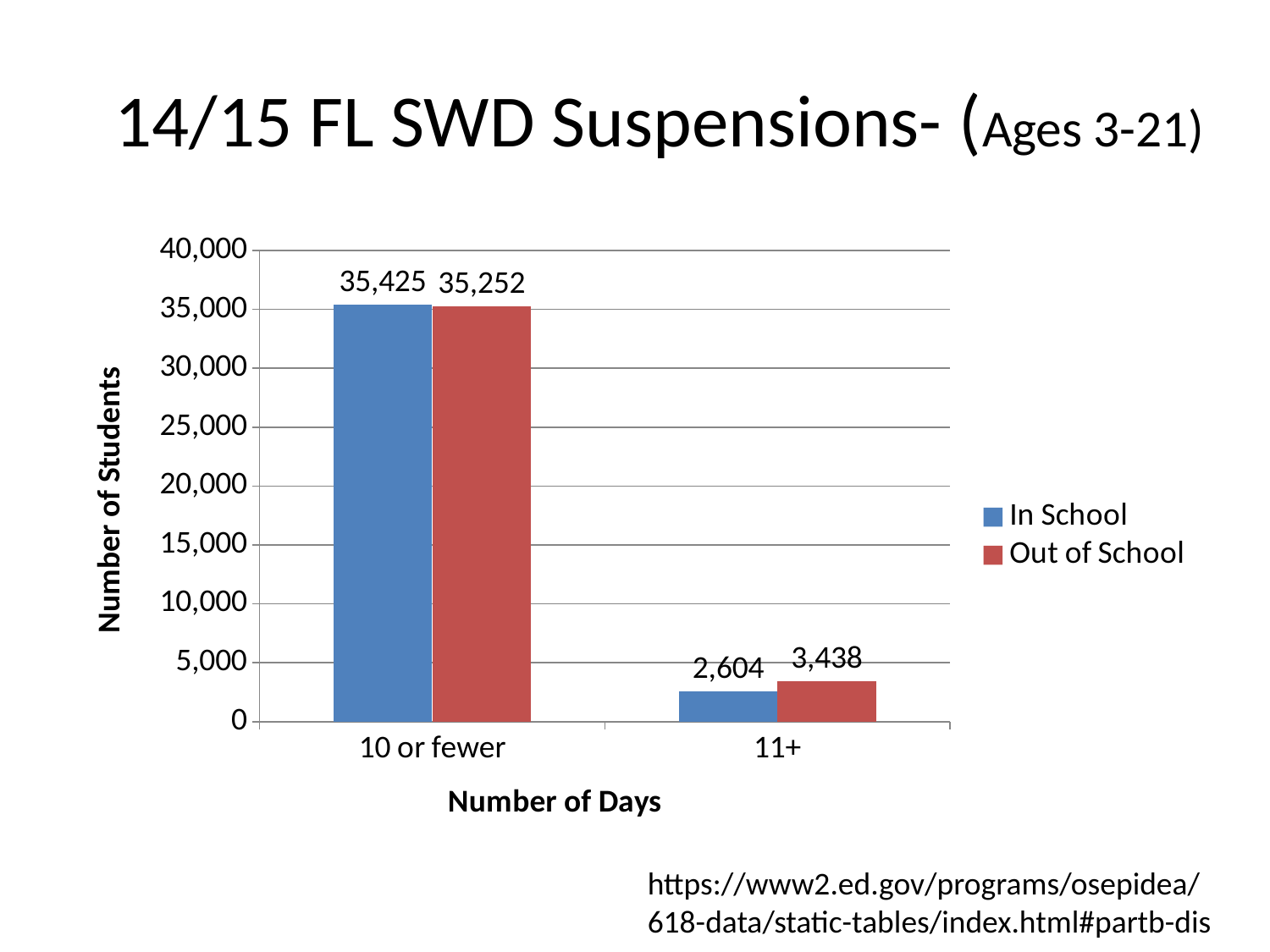
What kind of chart is shown on the slide? Bar chart Which category has the highest In School value? 10 or fewer What is the difference between the In School and Out of School values for the "11+" category? 834 What is the In School value for the "11+" days category? 2,604 What is the In School value for the "10 or fewer" days category? 35,425 Which category has the lowest Out of School value? 11+ What is the Out of School value for the "11+" days category? 3,438 What is the difference between the In School and Out of School values for the "10 or fewer" category? 173 What is the Out of School value for the "10 or fewer" days category? 35,252 For the "11+" category, which is larger: In School or Out of School? Out of School What is the label of the x axis? Number of Days How many series does the legend list? 2